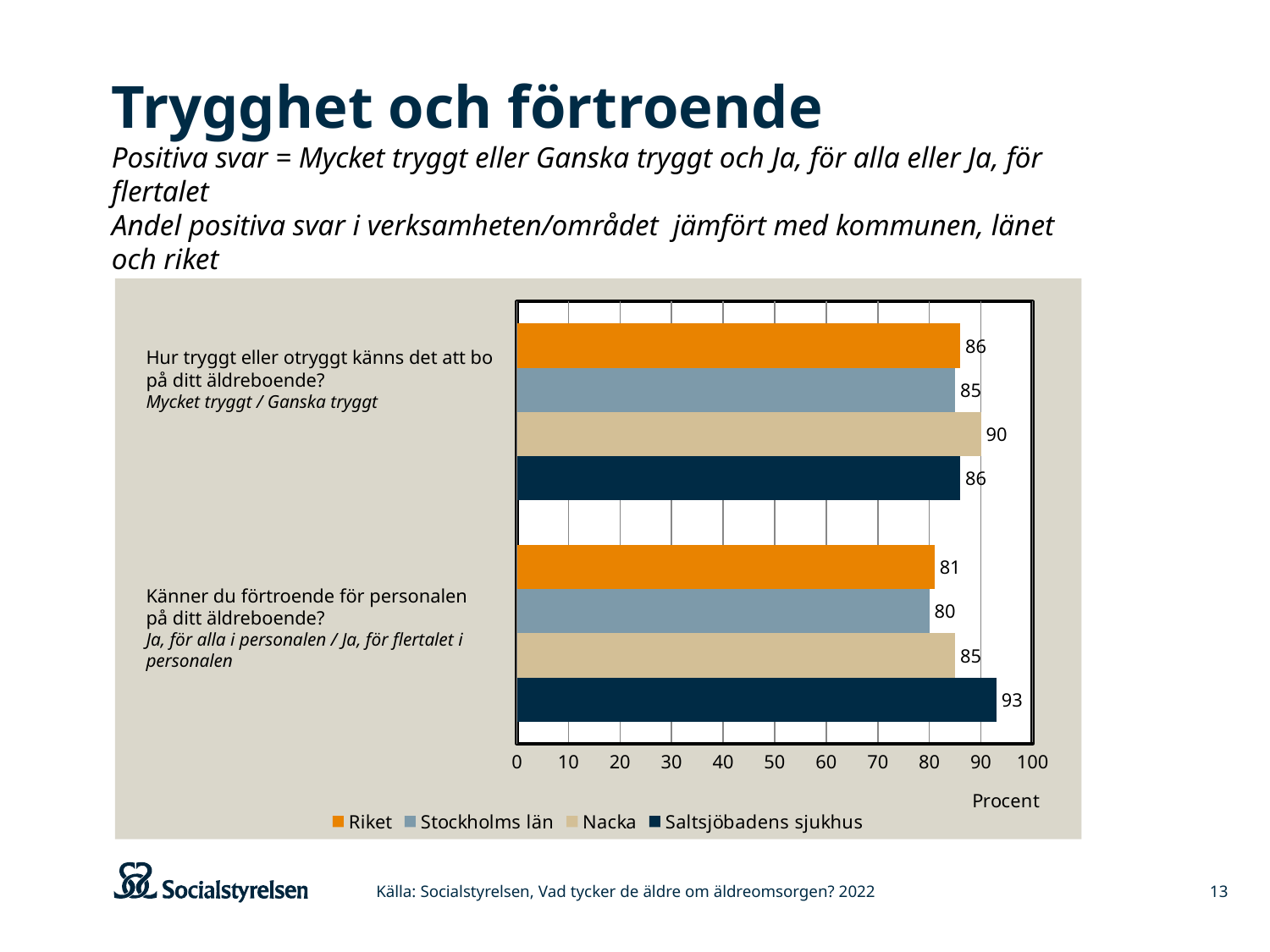
What is the value for Saltsjöbadens sjukhus on the question "Känner du förtroende för personalen på ditt äldreboende?"? 93 Which series has the highest value on the question "Hur tryggt eller otryggt känns det att bo på ditt äldreboende?"? Nacka Which series has the highest value on the question "Känner du förtroende för personalen på ditt äldreboende?"? Saltsjöbadens sjukhus What is the difference between Saltsjöbadens sjukhus and Riket on the question "Känner du förtroende för personalen på ditt äldreboende?"? 12 What is the label of the x axis? Procent What is the value for Nacka on the question "Hur tryggt eller otryggt känns det att bo på ditt äldreboende?"? 90 Which series has the lowest value on the question "Känner du förtroende för personalen på ditt äldreboende?"? Stockholms län Is the value for Nacka on the question "Känner du förtroende för personalen på ditt äldreboende?" larger or smaller than the value for Saltsjöbadens sjukhus on the same question? Smaller What is the value for Riket on the question "Hur tryggt eller otryggt känns det att bo på ditt äldreboende?"? 86 How many series does the legend list? 4 What is the value for Stockholms län on the question "Känner du förtroende för personalen på ditt äldreboende?"? 80 What kind of chart is shown on the slide? Bar chart